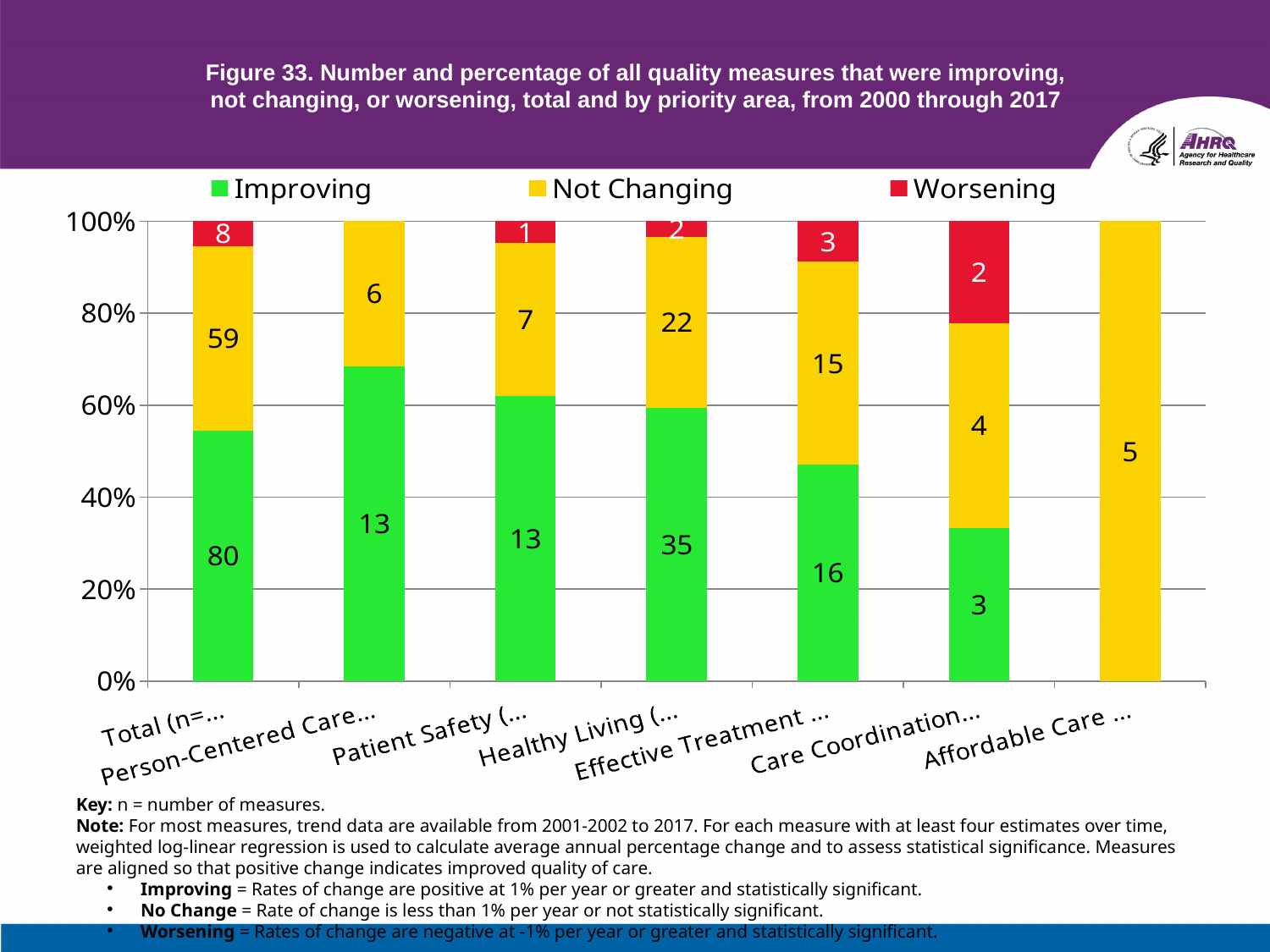
What is the number of Improving measures for Care Coordination? 3 How many priority-area categories (bars) are shown on the x axis? 7 What is the number of Worsening measures for Effective Treatment? 3 What is the difference between the Improving and Not Changing counts for Effective Treatment? 1 What type of chart is shown on the slide? Stacked bar chart What is the total number of measures in the Healthy Living bar (sum of Improving, Not Changing and Worsening)? 59 What is the number of Improving measures in the Total bar? 80 How many series does the legend list? 3 Which has more Improving measures, Patient Safety or Healthy Living? Healthy Living What is the total number of measures in the Total bar (sum of Improving, Not Changing and Worsening)? 147 What is the number of Not Changing measures for Healthy Living? 22 What is the number of Not Changing measures for Affordable Care? 5